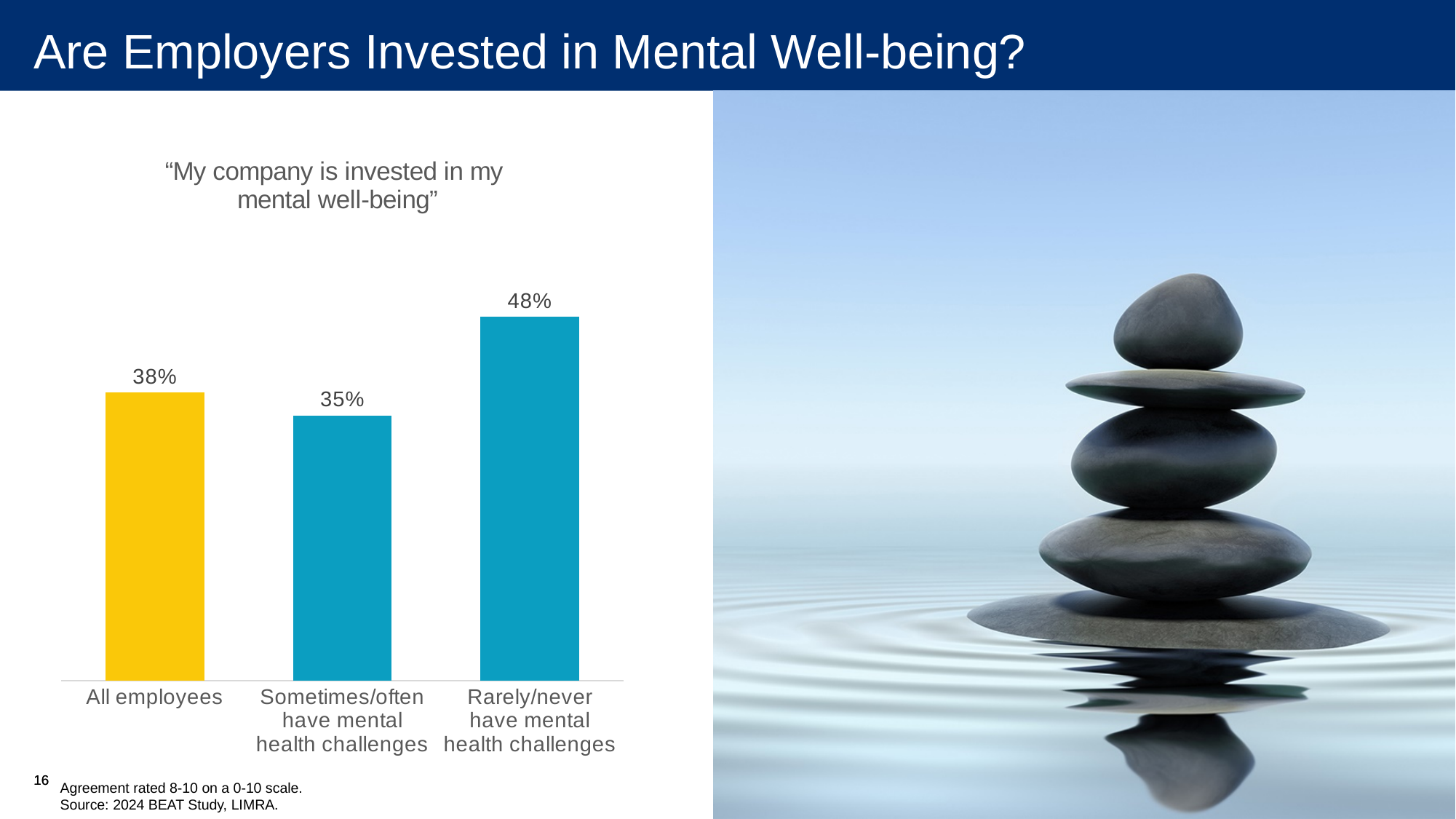
Which category has the lowest value? Sometimes/often have mental health challenges What is the difference between the values for Rarely/never have mental health challenges and Sometimes/often have mental health challenges? 13% What kind of chart is shown on the slide? Bar chart Which category has the highest value? Rarely/never have mental health challenges How many categories are shown in the chart? 3 What is the value for employees who sometimes/often have mental health challenges? 35% Which bar is coloured yellow? All employees What is the value for employees who rarely/never have mental health challenges? 48% What is the value for All employees? 38% What is the title of the chart? "My company is invested in my mental well-being" What is the difference between the values for All employees and Sometimes/often have mental health challenges? 3% Which is larger, the value for All employees or the value for Rarely/never have mental health challenges? Rarely/never have mental health challenges